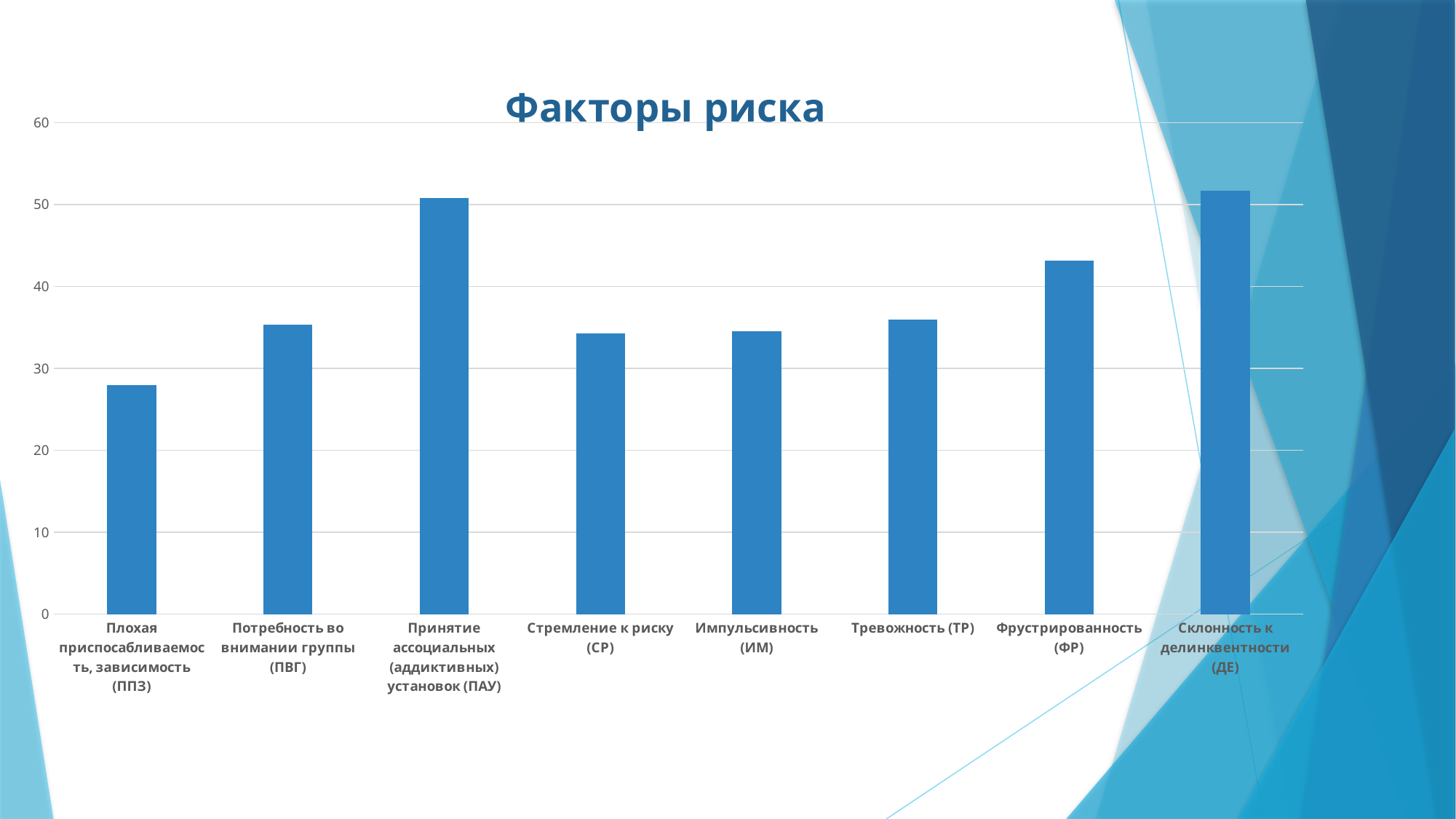
How many categories are plotted in the chart? 8 What kind of chart is shown on the slide? bar chart Is the value for Тревожность (ТР) greater or less than 40? less What is the title of the chart? Факторы риска Which is larger, the value for Фрустрированность (ФР) or the value for Тревожность (ТР)? Фрустрированность (ФР) Which category has the lowest value? Плохая приспосабливаемость, зависимость (ППЗ) Which is larger, the value for Принятие ассоциальных (аддиктивных) установок (ПАУ) or the value for Фрустрированность (ФР)? Принятие ассоциальных (аддиктивных) установок (ПАУ) Is the value for Фрустрированность (ФР) greater or less than 40? greater Is the value for Принятие ассоциальных (аддиктивных) установок (ПАУ) greater or less than 50? greater Which is larger, the value for Потребность во внимании группы (ПВГ) or the value for Плохая приспосабливаемость, зависимость (ППЗ)? Потребность во внимании группы (ПВГ)